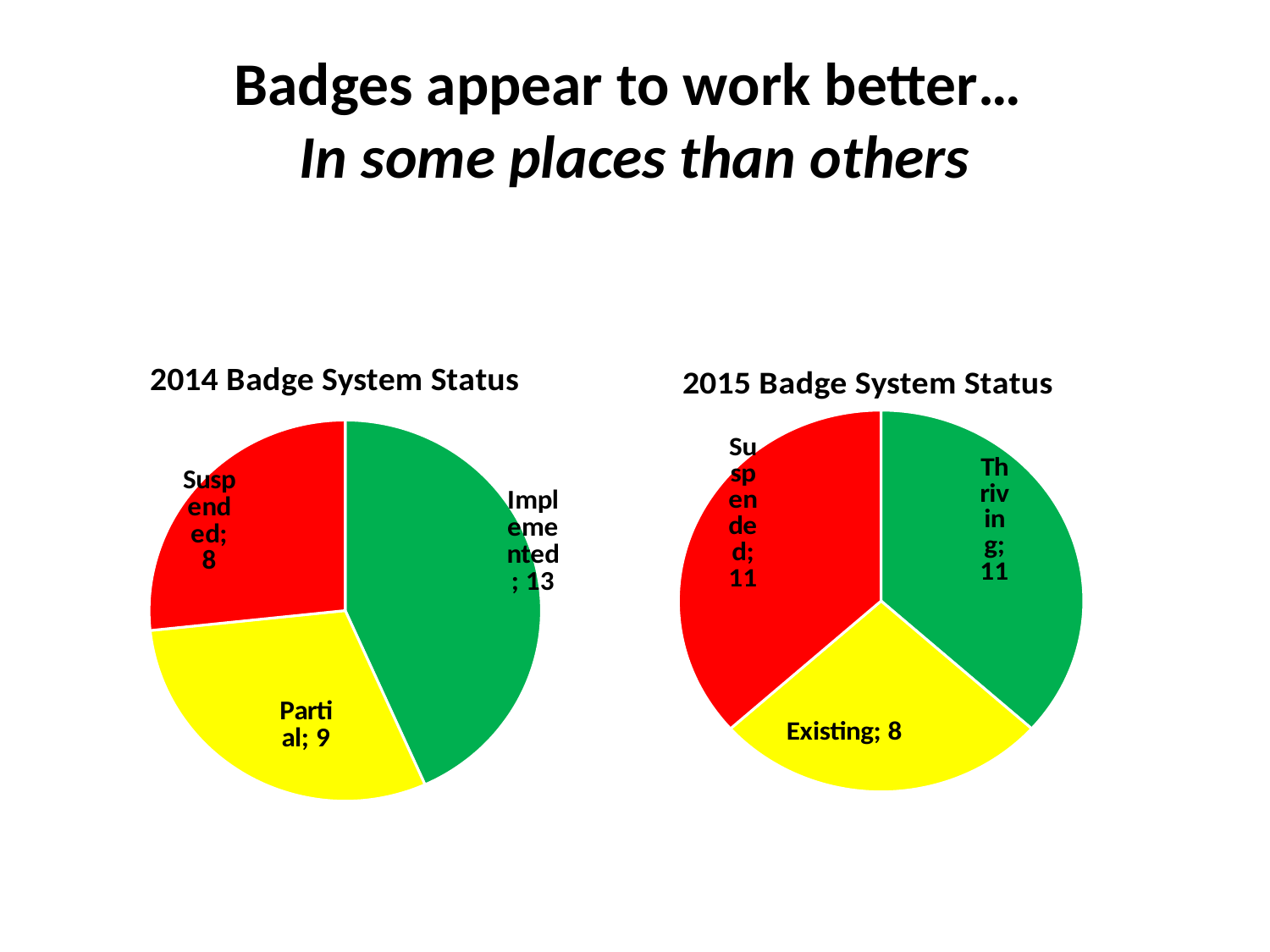
In the 2015 Badge System Status chart, what is the value for Suspended? 11 In the 2014 Badge System Status chart, what share of the total does Partial represent? 30% In the 2014 Badge System Status chart, what is the difference between Implemented and Suspended? 5 In the 2014 Badge System Status chart, which category has the largest slice? Implemented How many slices does the 2015 Badge System Status chart have? 3 In the 2014 Badge System Status chart, what is the value for Partial? 9 In the 2014 Badge System Status chart, which category has the smallest slice? Suspended What type of chart is the 2014 Badge System Status chart? Pie chart In the 2014 Badge System Status chart, what is the value for Implemented? 13 In the 2015 Badge System Status chart, which category has the smallest slice? Existing In the 2015 Badge System Status chart, what is the value for Existing? 8 Which is larger: Suspended in the 2014 chart or Suspended in the 2015 chart? Suspended in the 2015 chart